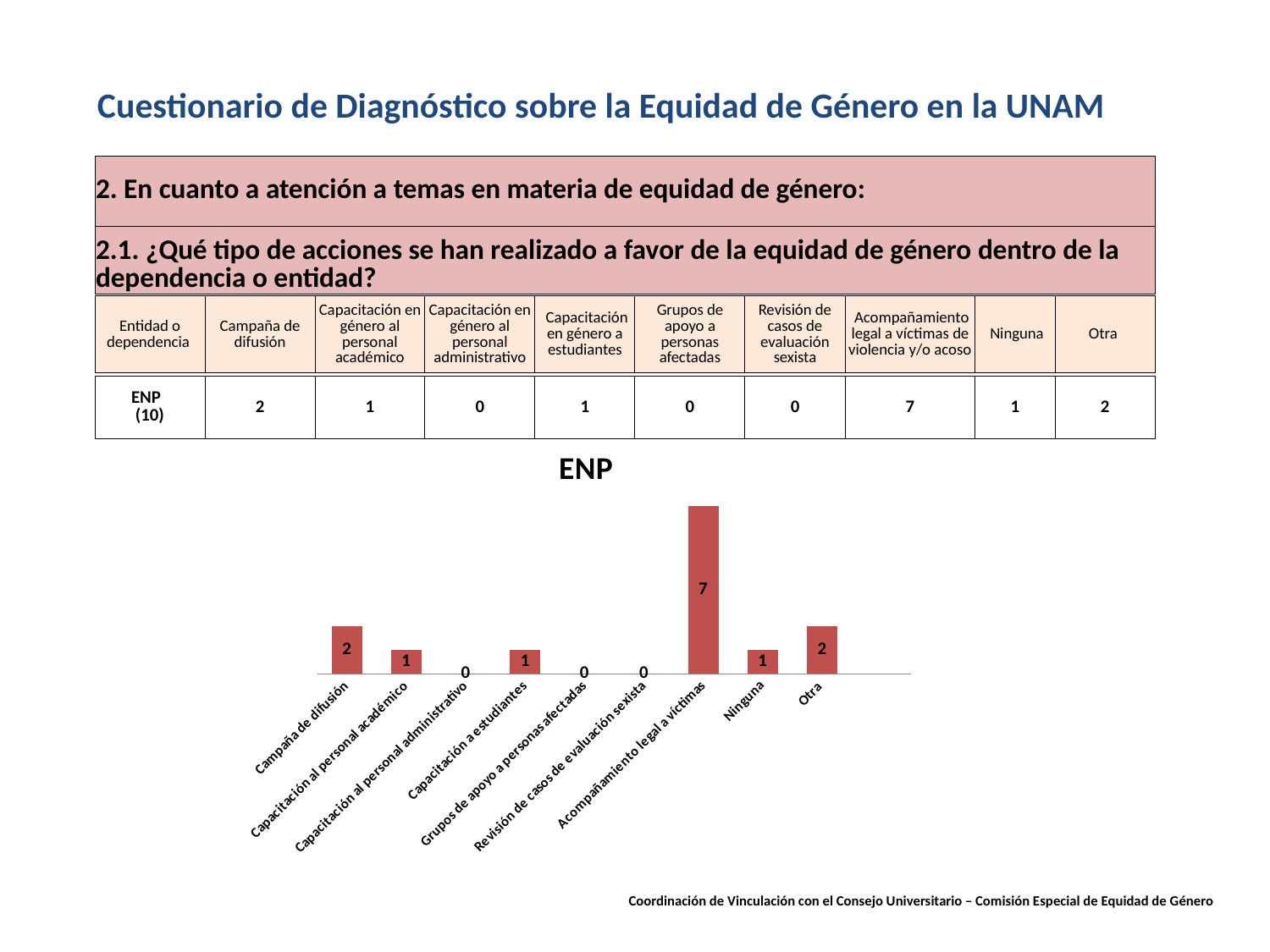
How many categories in the ENP chart have a value of 0? 3 How many categories are shown in the ENP chart? 9 What is the value for Campaña de difusión in the ENP chart? 2 What is the value for Ninguna in the ENP chart? 1 Which category has the highest value in the ENP chart? Acompañamiento legal a víctimas What is the difference between the values for Acompañamiento legal a víctimas and Otra in the ENP chart? 5 What kind of chart is the ENP chart? bar chart What is the value for Capacitación al personal administrativo in the ENP chart? 0 What is the value for Acompañamiento legal a víctimas in the ENP chart? 7 What is the difference between the values for Otra and Ninguna in the ENP chart? 1 Which is larger in the ENP chart, Campaña de difusión or Capacitación a estudiantes? Campaña de difusión What is the title of the chart on the slide? ENP